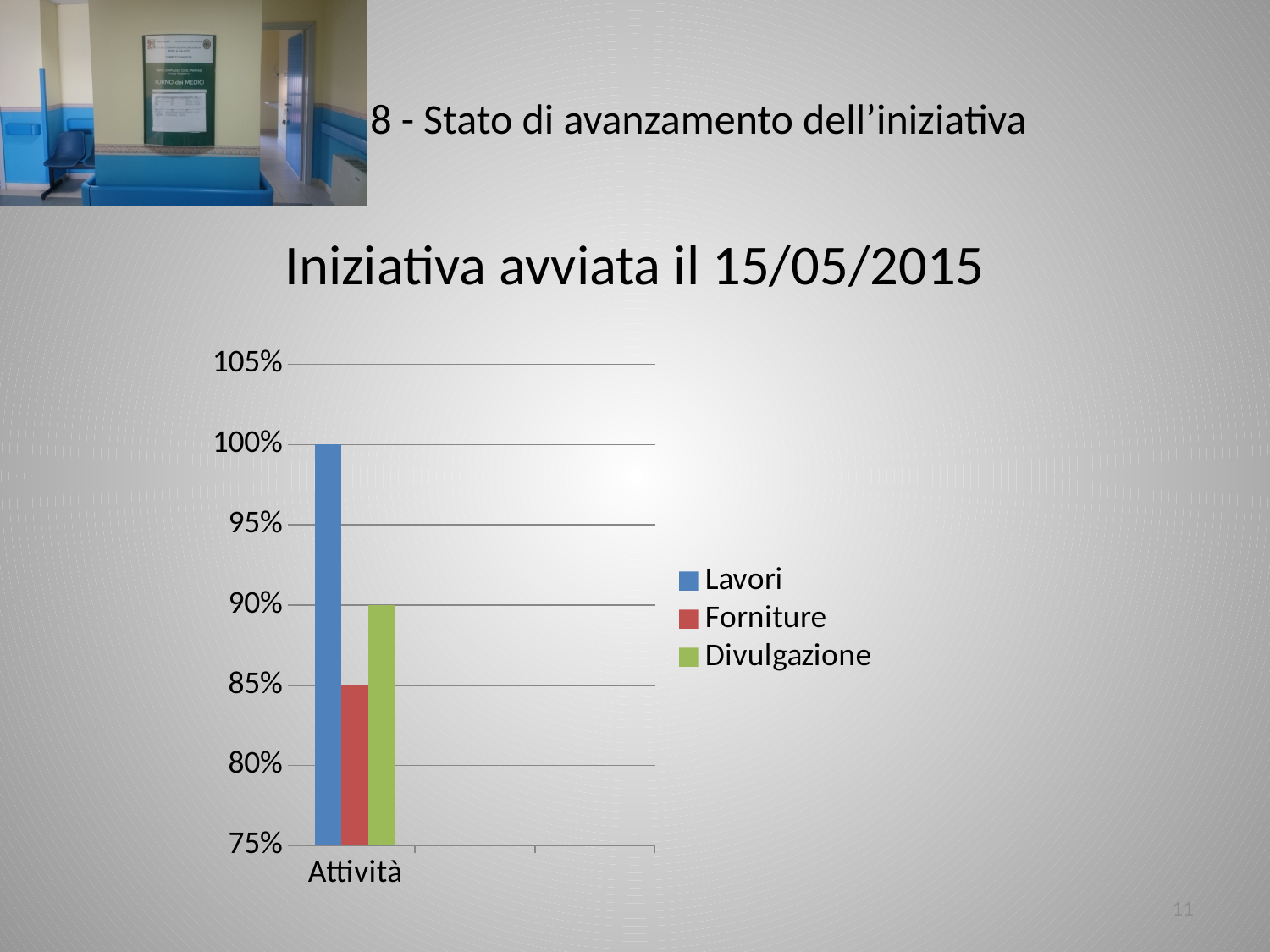
What is the difference between the values for Lavori and Forniture? 15% Which series has the highest value? Lavori Which series has the lowest value? Forniture What is the difference between the values for Divulgazione and Forniture? 5% How many categories are shown on the x axis? 1 What kind of chart is shown on the slide? bar chart What is the value for Forniture? 85% What is the value for Divulgazione? 90% What is the label of the category on the x axis? Attività Which is larger, the value for Divulgazione or the value for Forniture? Divulgazione How many series does the legend list? 3 What is the value for Lavori? 100%